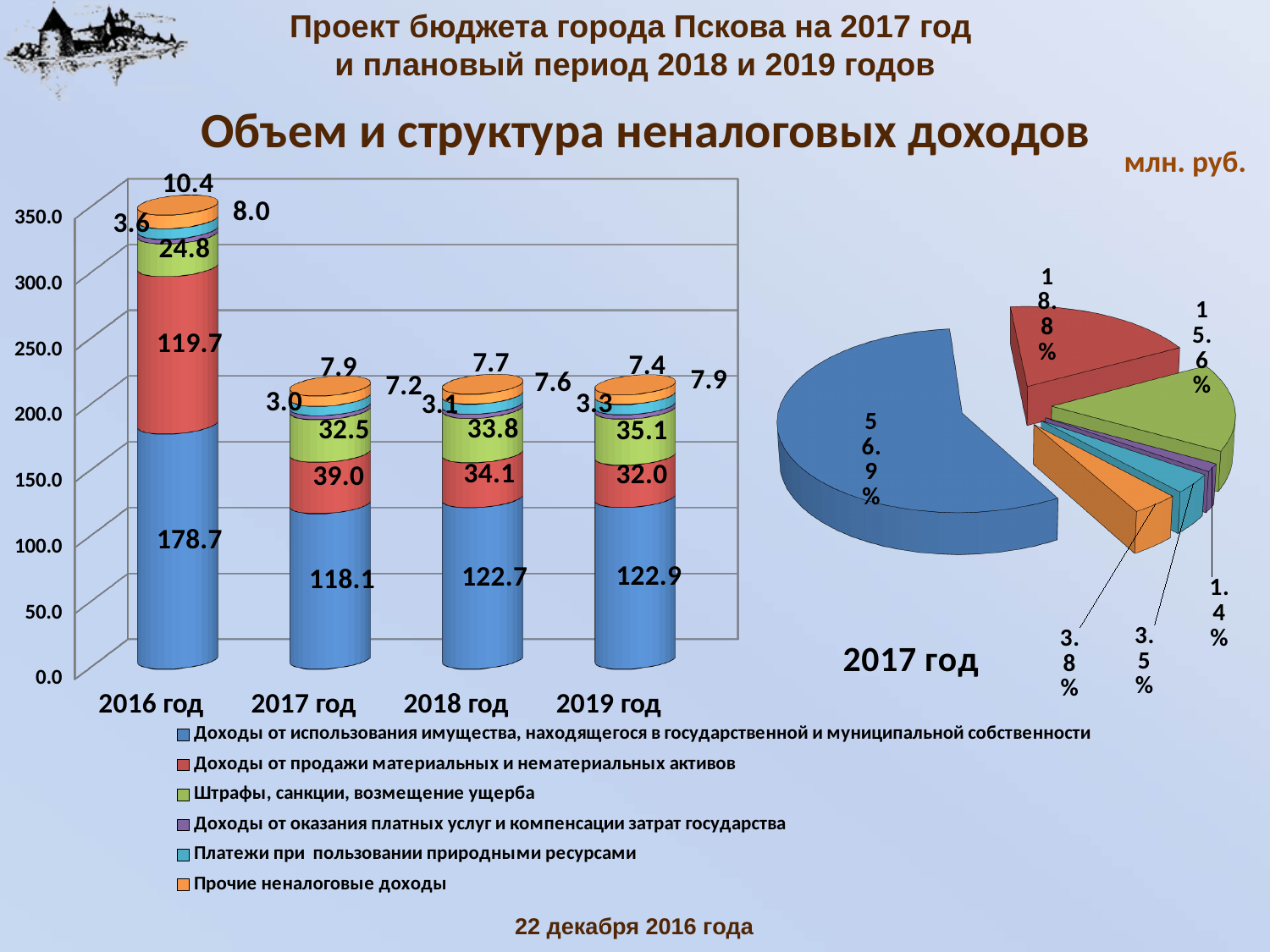
In the stacked bar chart on the left, what is the value for 'Штрафы, санкции, возмещение ущерба' in 2019 год? 35.1 In the stacked bar chart on the left, what is the value for 'Доходы от использования имущества, находящегося в государственной и муниципальной собственности' in 2016 год? 178.7 In the pie chart on the right (2017 год), what share does the largest slice have? 56.9% How many series does the legend of the stacked bar chart list? 6 In the stacked bar chart on the left, what is the value for 'Доходы от продажи материальных и нематериальных активов' in 2018 год? 34.1 In the stacked bar chart on the left, which year has the lowest value for 'Доходы от использования имущества, находящегося в государственной и муниципальной собственности'? 2017 год In the pie chart on the right (2017 год), which is larger: the share for 'Доходы от продажи материальных и нематериальных активов' or the share for 'Штрафы, санкции, возмещение ущерба'? Доходы от продажи материальных и нематериальных активов In the stacked bar chart on the left, what is the difference between the 2016 год and 2017 год values for 'Доходы от продажи материальных и нематериальных активов'? 80.7 In the stacked bar chart on the left, which year has the highest value for 'Доходы от продажи материальных и нематериальных активов'? 2016 год What unit is shown for the values on the slide? млн. руб. In the stacked bar chart on the left, is the total of the 2016 год bar greater or less than 300.0? greater In the stacked bar chart on the left, what is the total of the 2017 год bar? 207.7